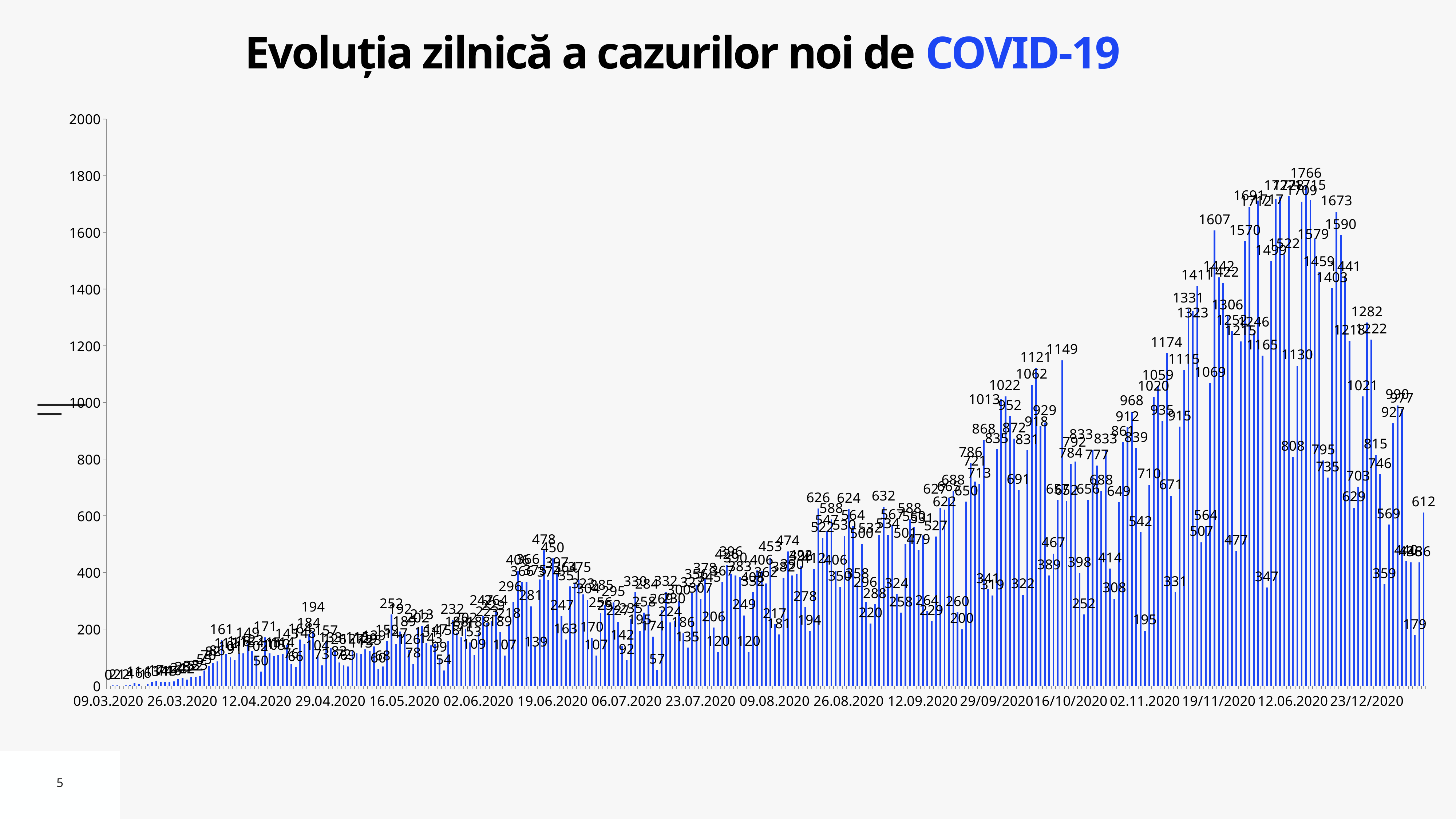
What is the difference between the highest labelled value (1766) and the last bar's value (612)? 1154 What colour are the bars in the chart? blue What is the maximum value shown on the y axis? 2000 Which is larger: the highest labelled value (1766) or the last bar's value (612)? 1766 What is the title of the chart? Evoluția zilnică a cazurilor noi de COVID-19 Overall, do the daily values rise or fall from left to right along the x axis? rise What kind of chart is shown on the slide? bar chart What is the highest daily value labelled on the chart? 1766 Is the highest bar on the chart greater or less than 1600? greater What is the value of the last (rightmost) bar on the chart? 612 What is the first date label on the x axis? 09.03.2020 Is the last (rightmost) bar greater or less than 800? less